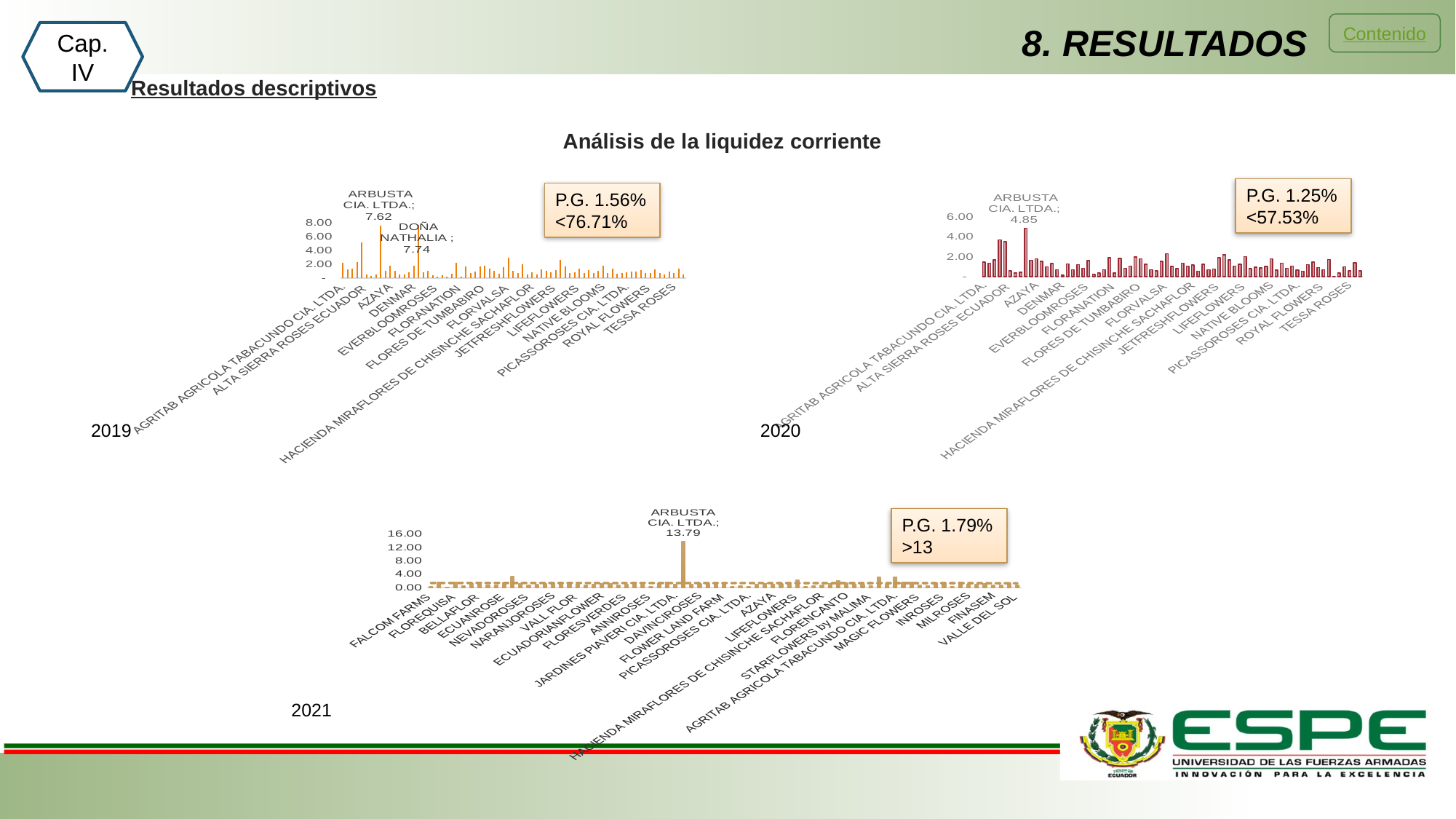
In the 2019 chart, what is the difference between the labelled values for DOÑA NATHALIA and ARBUSTA CIA. LTDA.? 0.12 What is the overall title shown above the charts on the slide? Análisis de la liquidez corriente In the 2020 chart, what is the value labelled for ARBUSTA CIA. LTDA.? 4.85 Is the labelled value for ARBUSTA CIA. LTDA. larger in the 2019 chart or in the 2021 chart? 2021 In the 2020 chart, which company has the highest value? ARBUSTA CIA. LTDA. What kind of chart is used for the 2021 data? Bar chart In the 2021 chart, which company has the highest current liquidity value? ARBUSTA CIA. LTDA. In the 2019 chart, what is the value labelled for DOÑA NATHALIA? 7.74 In the 2021 chart, is the value for ARBUSTA CIA. LTDA. greater or less than 12.00? greater In the 2021 chart, what is the value labelled for ARBUSTA CIA. LTDA.? 13.79 In the 2019 chart, what is the value labelled for ARBUSTA CIA. LTDA.? 7.62 In the 2020 chart, is the value for ARBUSTA CIA. LTDA. greater or less than 6.00? less